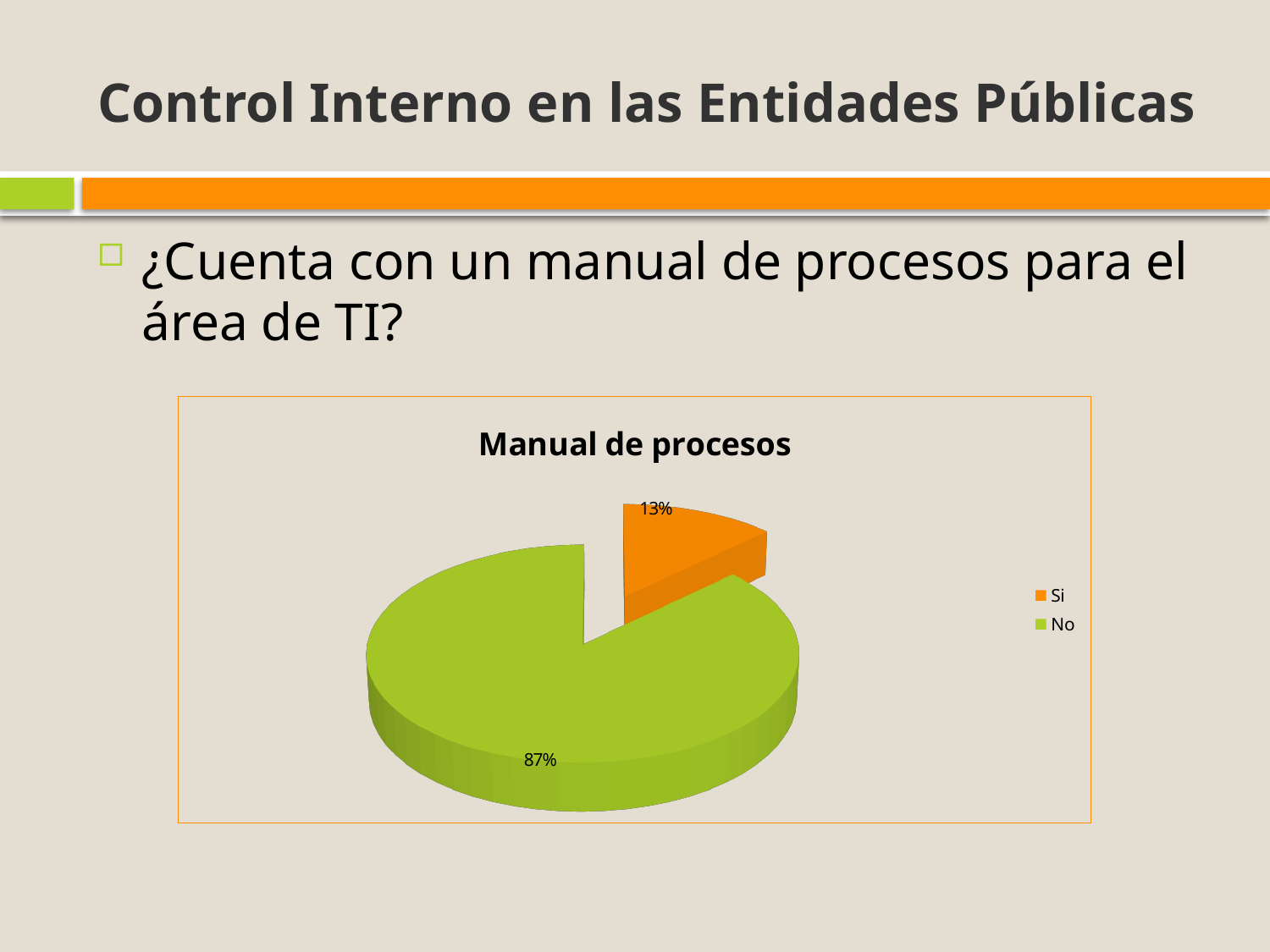
Which category has the smallest share of the pie? Si What kind of chart is shown on the slide? pie chart Which is larger, the 'Si' slice or the 'No' slice? No What is the difference in percentage points between the 'No' and 'Si' slices? 74 What colour is the 'Si' slice? orange How many categories does the pie chart have? 2 Which category has the largest share of the pie? No What percentage of the pie does the 'No' slice represent? 87% What is the title of the chart? Manual de procesos What percentage of the pie does the 'Si' slice represent? 13% How many entries does the legend list? 2 Is the share for 'No' greater or less than 50%? greater